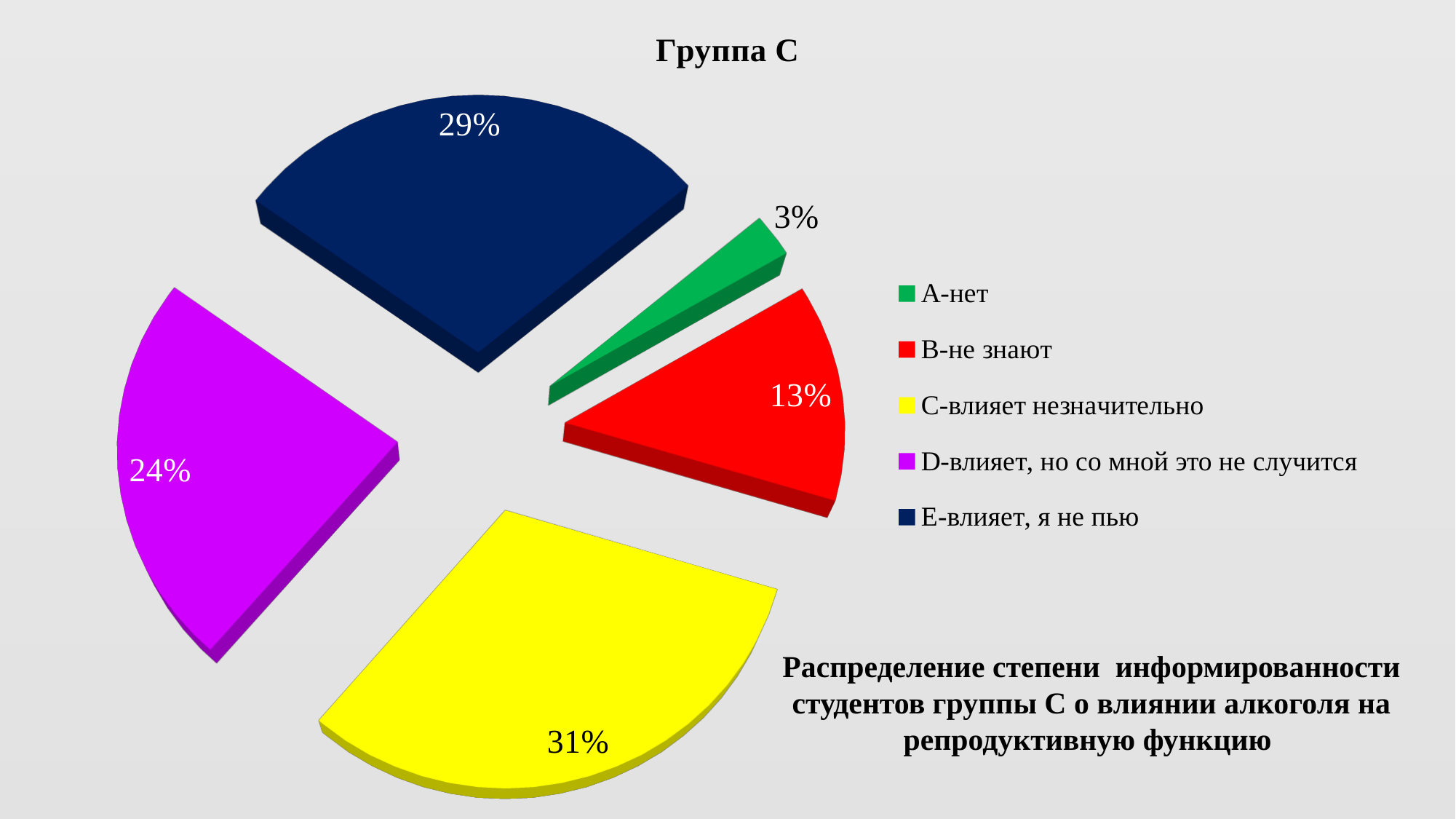
What share of the pie does the slice "A-нет" have? 3% What share of the pie does the slice "E-влияет, я не пью" have? 29% What is the chart's title? Группа С Which category has the largest slice? C-влияет незначительно What is the difference in percentage points between "E-влияет, я не пью" and "D-влияет, но со мной это не случится"? 5% Which is larger, the slice for "B-не знают" or the slice for "D-влияет, но со мной это не случится"? D-влияет, но со мной это не случится What share of the pie does the slice "D-влияет, но со мной это не случится" have? 24% What kind of chart is shown on the slide? pie chart Which category has the smallest slice? A-нет How many categories does the legend list? 5